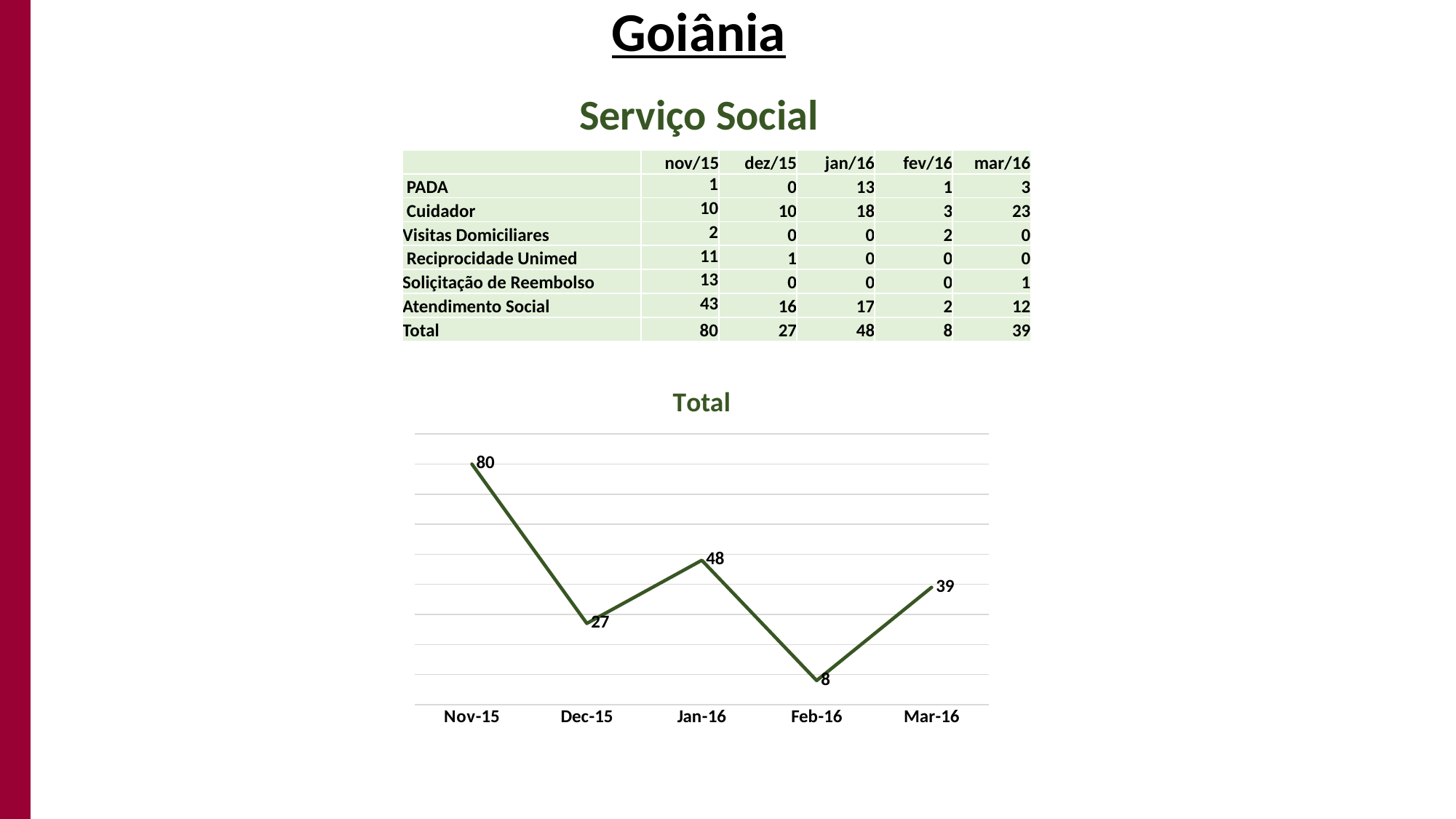
What is the difference between the Jan-16 and Feb-16 values in the Total chart? 40 Which month has the highest value in the Total chart? Nov-15 What is the value for Nov-15 in the Total chart? 80 Which month has the lowest value in the Total chart? Feb-16 Which is larger in the Total chart, the value for Jan-16 or the value for Mar-16? Jan-16 Does the value in the Total chart rise or fall from Dec-15 to Jan-16? rise How many data points are plotted in the Total chart? 5 What kind of chart is the Total chart? line chart What is the title of the chart on the slide? Total What is the value for Feb-16 in the Total chart? 8 What is the difference between the Nov-15 and Dec-15 values in the Total chart? 53 What is the value for Mar-16 in the Total chart? 39